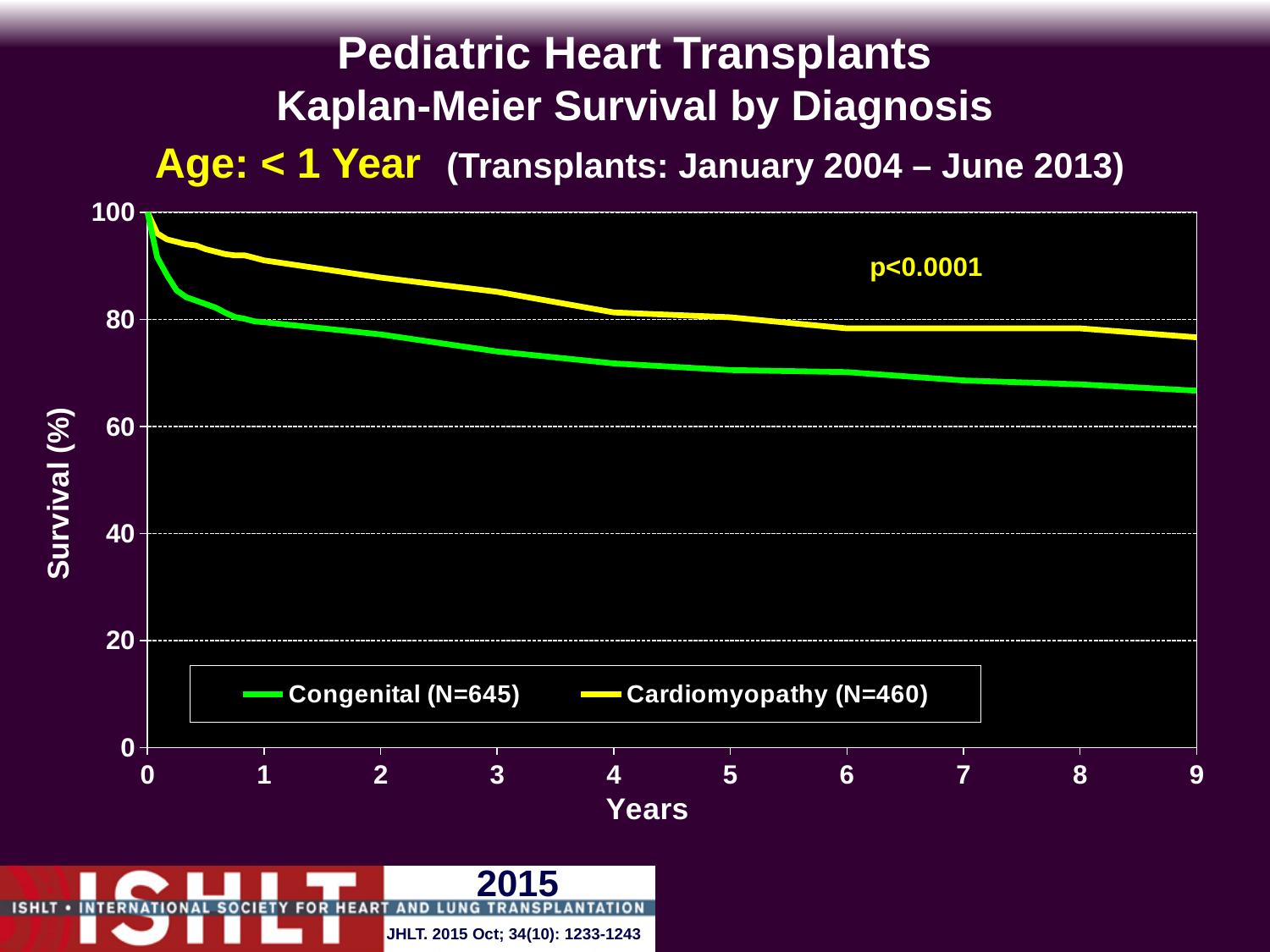
Is the survival for Cardiomyopathy at 9 years greater or less than 80? less What is the maximum value shown on the Survival (%) axis? 100 What is the N for the Congenital group shown in the legend? 645 What kind of chart is shown on the slide? line chart How many series does the legend list? 2 Do the survival curves rise or fall as years increase? fall Which diagnosis group shows the lower survival curve across the follow-up period? Congenital What p-value is printed on the chart? p<0.0001 Is the survival for Congenital at 9 years greater or less than 80? less Which series has the higher survival at 5 years, Congenital or Cardiomyopathy? Cardiomyopathy Is the survival for Cardiomyopathy at 1 year greater or less than 80? greater